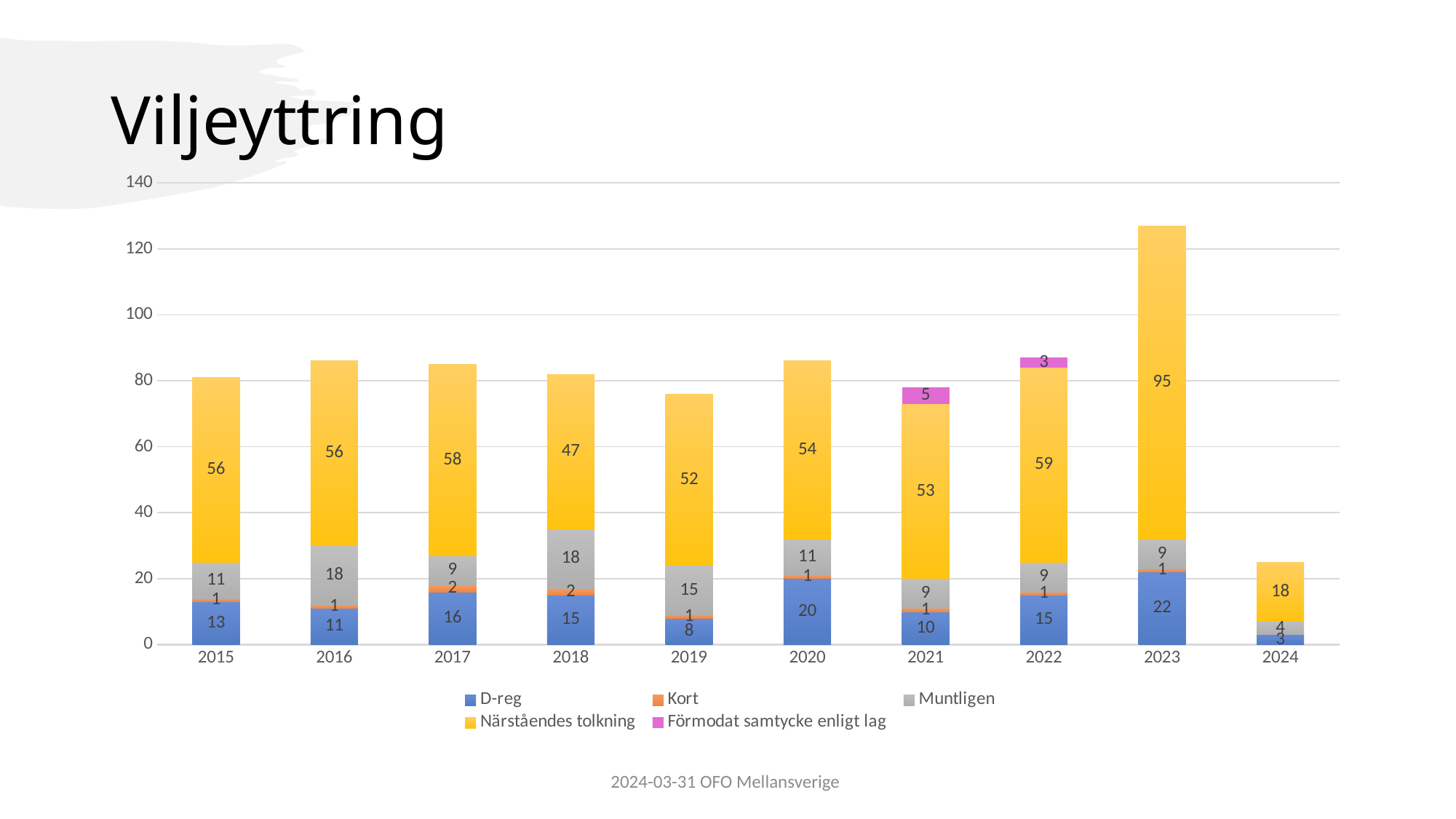
Is the total height of the 2023 bar greater or less than 120? greater What is the value of Närståendes tolkning for 2023? 95 What is the value of Förmodat samtycke enligt lag in 2021? 5 Which year has the highest D-reg value? 2023 What is the total of the stacked bar for 2015? 81 What kind of chart is shown on the slide? Stacked bar chart How many series does the legend list? 5 What is the difference between the Närståendes tolkning values for 2023 and 2022? 36 What is the D-reg value for 2020? 20 How many years are shown on the x axis? 10 Which year has the lowest Närståendes tolkning value? 2024 Which year has the larger Muntligen value, 2016 or 2017? 2016